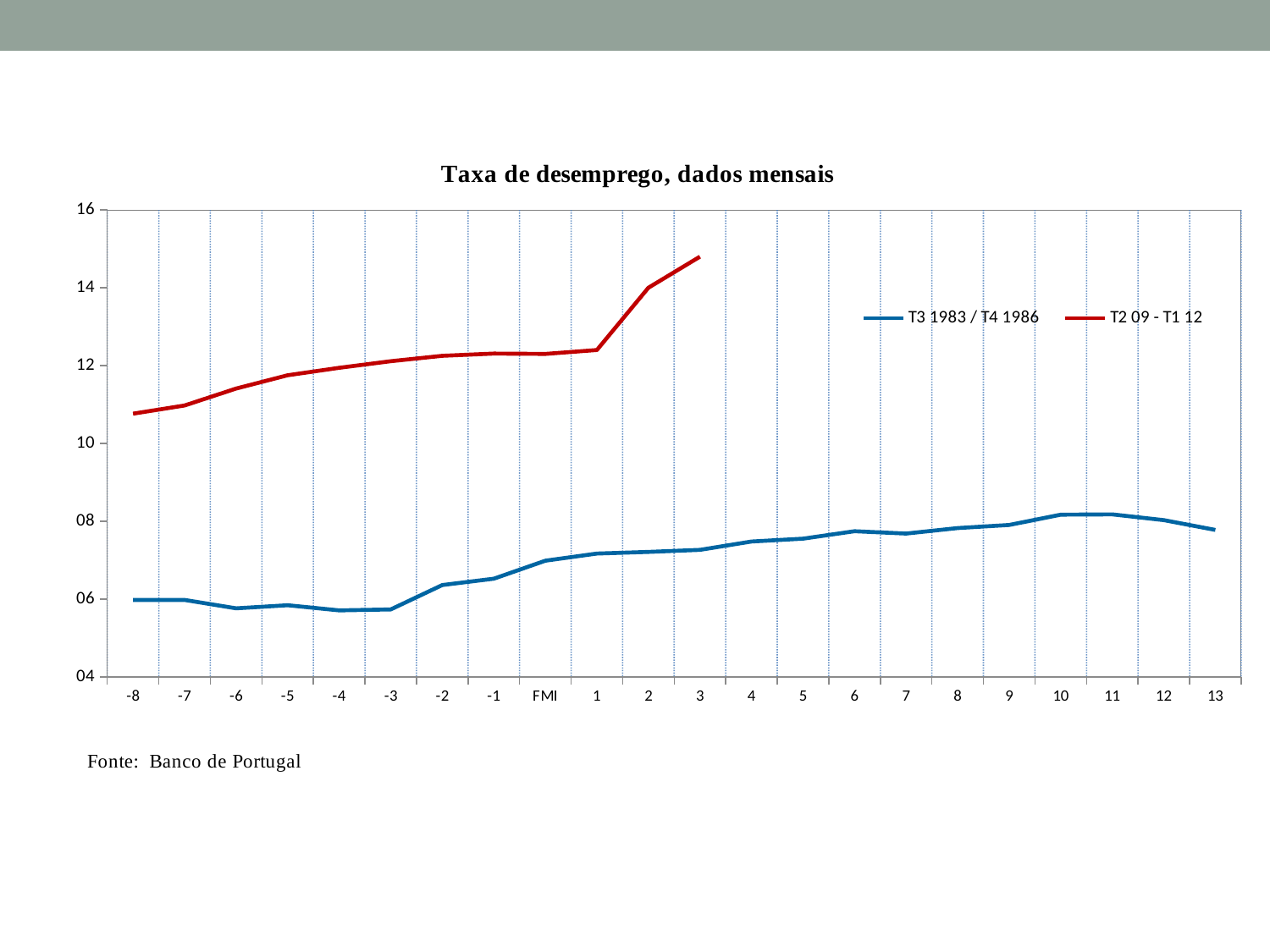
Is the value of the T3 1983 / T4 1986 series at 13 greater or less than 8? less How many points are labelled along the x axis? 22 Is the value of the T3 1983 / T4 1986 series at -3 greater or less than 6? less Is the value of the T2 09 - T1 12 series at 3 greater or less than 14? greater What is the title of the chart? Taxa de desemprego, dados mensais At FMI, which series has the higher value, T3 1983 / T4 1986 or T2 09 - T1 12? T2 09 - T1 12 What kind of chart is shown on the slide? line chart Which series is drawn in red? T2 09 - T1 12 Does the T2 09 - T1 12 series rise or fall from -8 to 3? rise At which x-axis point does the T2 09 - T1 12 series reach its highest value? 3 How many series does the legend list? 2